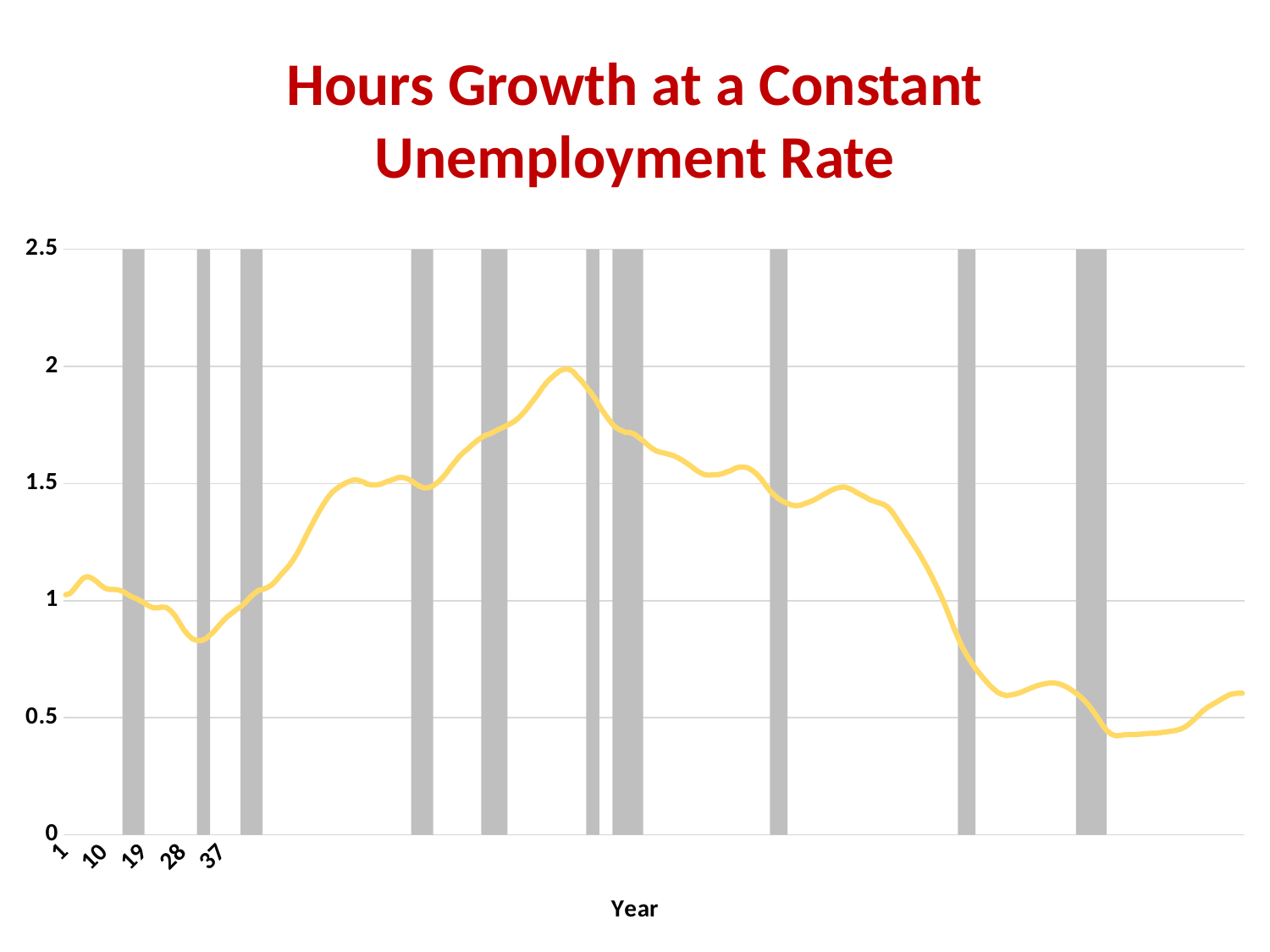
Is the lowest value reached by the line greater or less than 0.5? less Comparing the first point and the last point of the line, which is higher? the first point Is the value at year 28 greater or less than 1? less What is the highest value shown on the y axis? 2.5 Is the highest value reached by the line greater or less than 1.5? greater What is the label on the x axis of the chart? Year What is the title of the chart? Hours Growth at a Constant Unemployment Rate Does the line rise or fall over the final third of the x axis? fall What kind of chart is shown on the slide? line chart